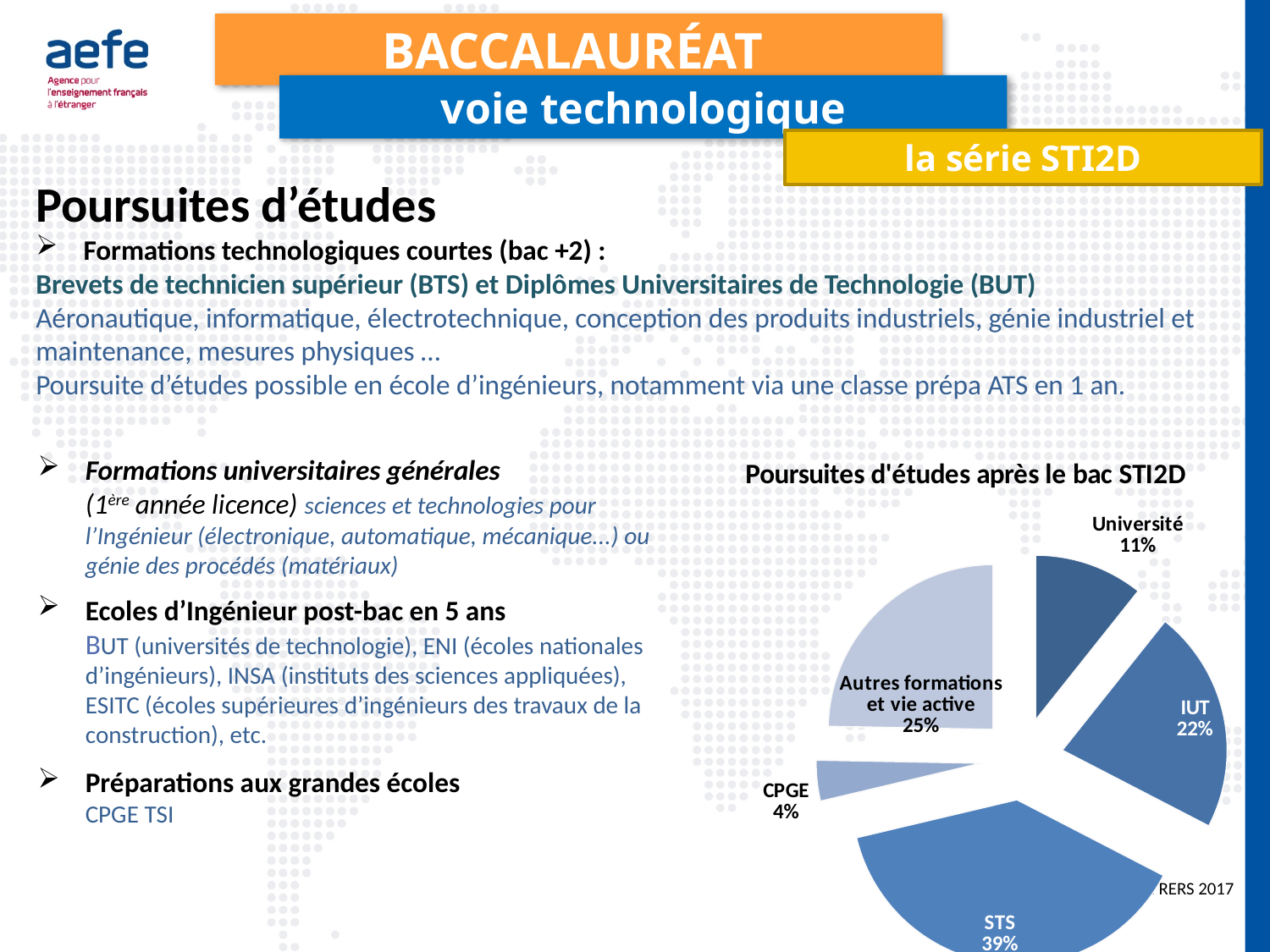
What is the difference in percentage points between STS and IUT? 17 What share of the pie does STS represent? 39% What share of the pie does Autres formations et vie active represent? 25% How many slices does the pie chart have? 5 What share of the pie does Université represent? 11% What share of the pie does IUT represent? 22% What share of the pie does CPGE represent? 4% Which category has the smallest share of the pie? CPGE What is the title of the chart? Poursuites d'études après le bac STI2D Which category has the largest share of the pie? STS Which is larger, the share for Autres formations et vie active or the share for IUT? Autres formations et vie active What type of chart is shown on the slide? pie chart